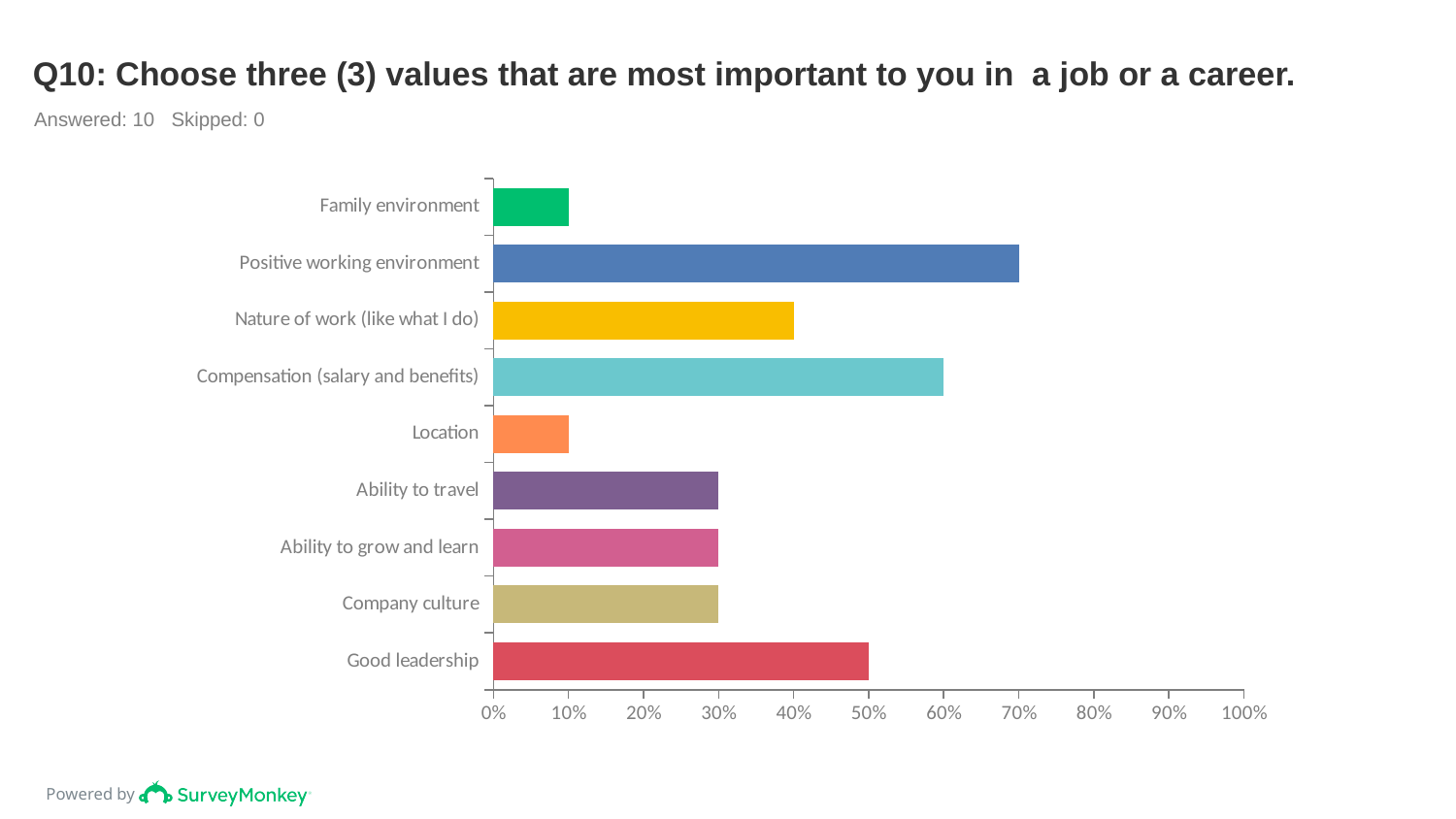
How many respondents answered the question according to the slide? 10 What is the value for Positive working environment? 70% What is the difference between the values for Positive working environment and Compensation (salary and benefits)? 10% What is the value for Compensation (salary and benefits)? 60% What kind of chart is shown on the slide? bar chart What is the value for Good leadership? 50% How many categories are shown on the chart? 9 Is the value for Ability to travel greater or less than 50%? less What is the value for Nature of work (like what I do)? 40% Which category has the highest value? Positive working environment What is the difference between the values for Good leadership and Company culture? 20% Which is larger, the value for Good leadership or the value for Nature of work (like what I do)? Good leadership